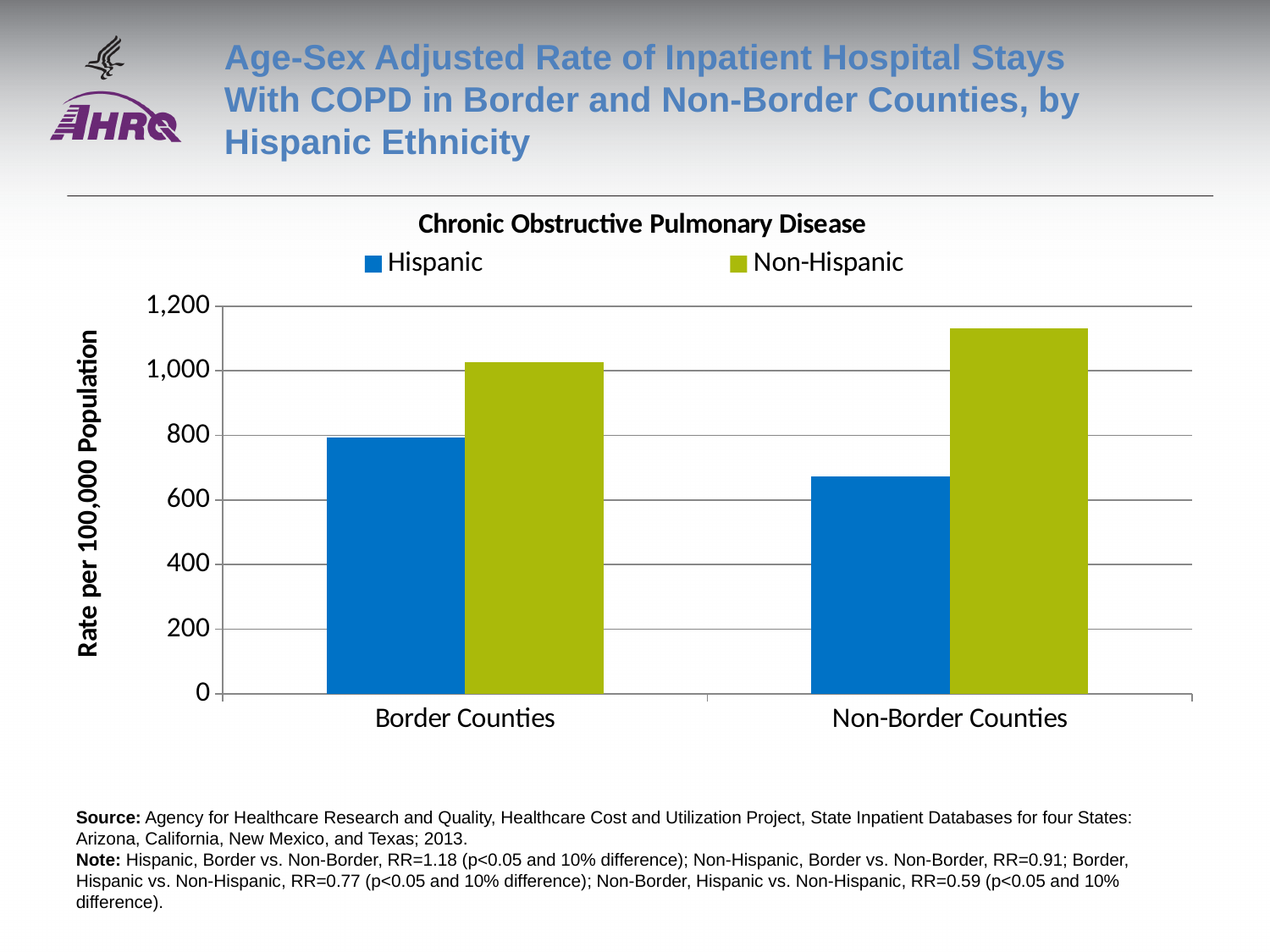
Which has the larger Hispanic rate, Border Counties or Non-Border Counties? Border Counties Is the Non-Hispanic value for Non-Border Counties greater or less than 1,000? greater What kind of chart is shown on the slide? bar chart What is the label of the y axis? Rate per 100,000 Population How many series does the legend list? 2 In Border Counties, which is larger, the Hispanic or the Non-Hispanic rate? Non-Hispanic Which bar is the lowest in the chart? Hispanic, Non-Border Counties Is the Non-Hispanic value for Border Counties greater or less than 1,000? greater Which bar is the highest in the chart? Non-Hispanic, Non-Border Counties Is the Hispanic value for Non-Border Counties greater or less than 600? greater How many categories are shown on the x axis? 2